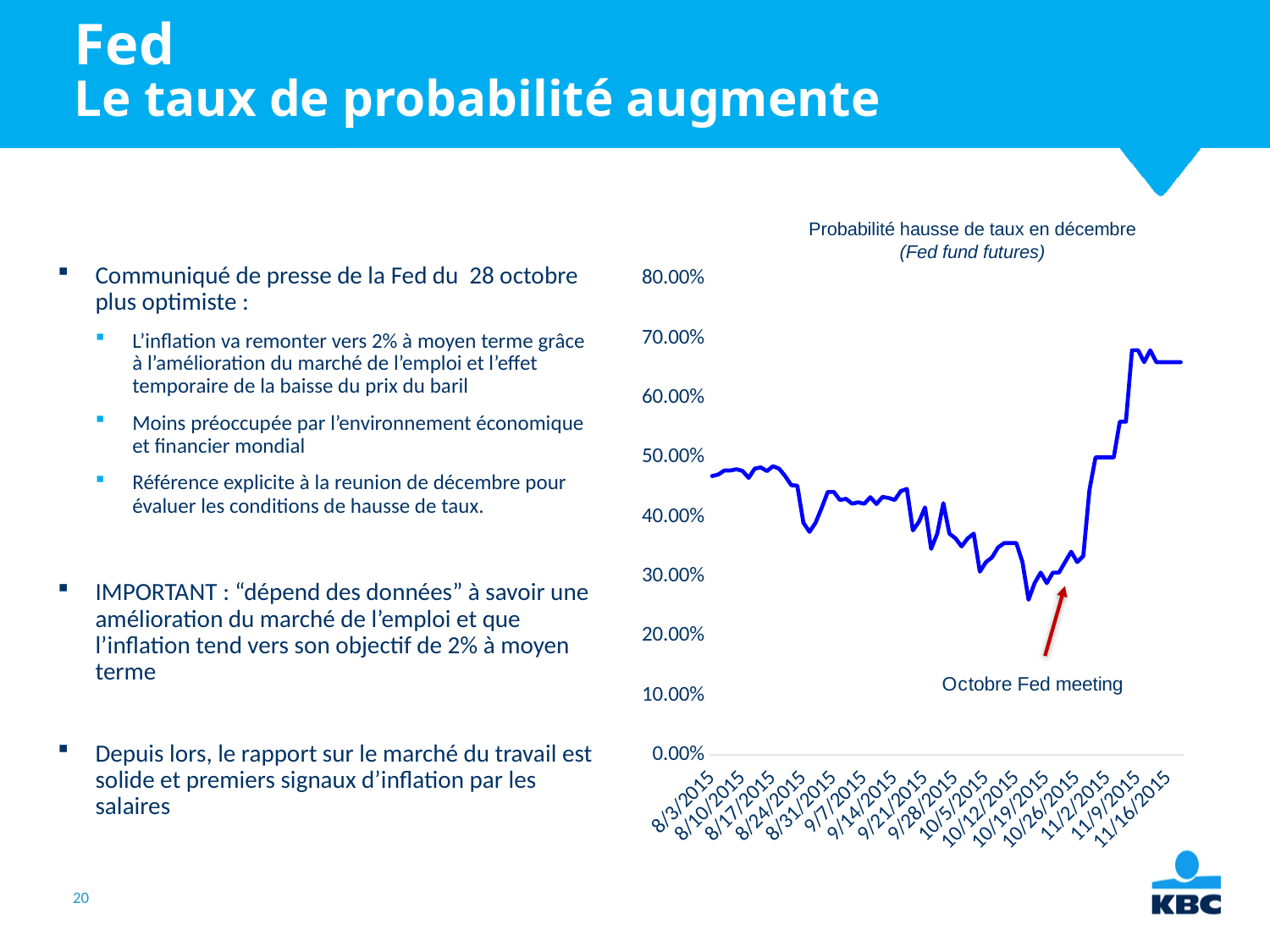
Is the value for 9/7/2015 greater or less than 50%? less What kind of chart is shown on the slide? line chart How many date labels are shown on the x axis of the chart? 16 What is the title of the chart? Probabilité hausse de taux en décembre (Fed fund futures) Is the value for 8/3/2015 greater or less than 40%? greater Is the highest value on the chart greater or less than 70%? less What event does the red arrow annotation on the chart point to? Octobre Fed meeting Does the probability rise or fall between 8/3/2015 and mid-October 2015? fall Which is larger, the value for 8/3/2015 or the value for 11/16/2015? 11/16/2015